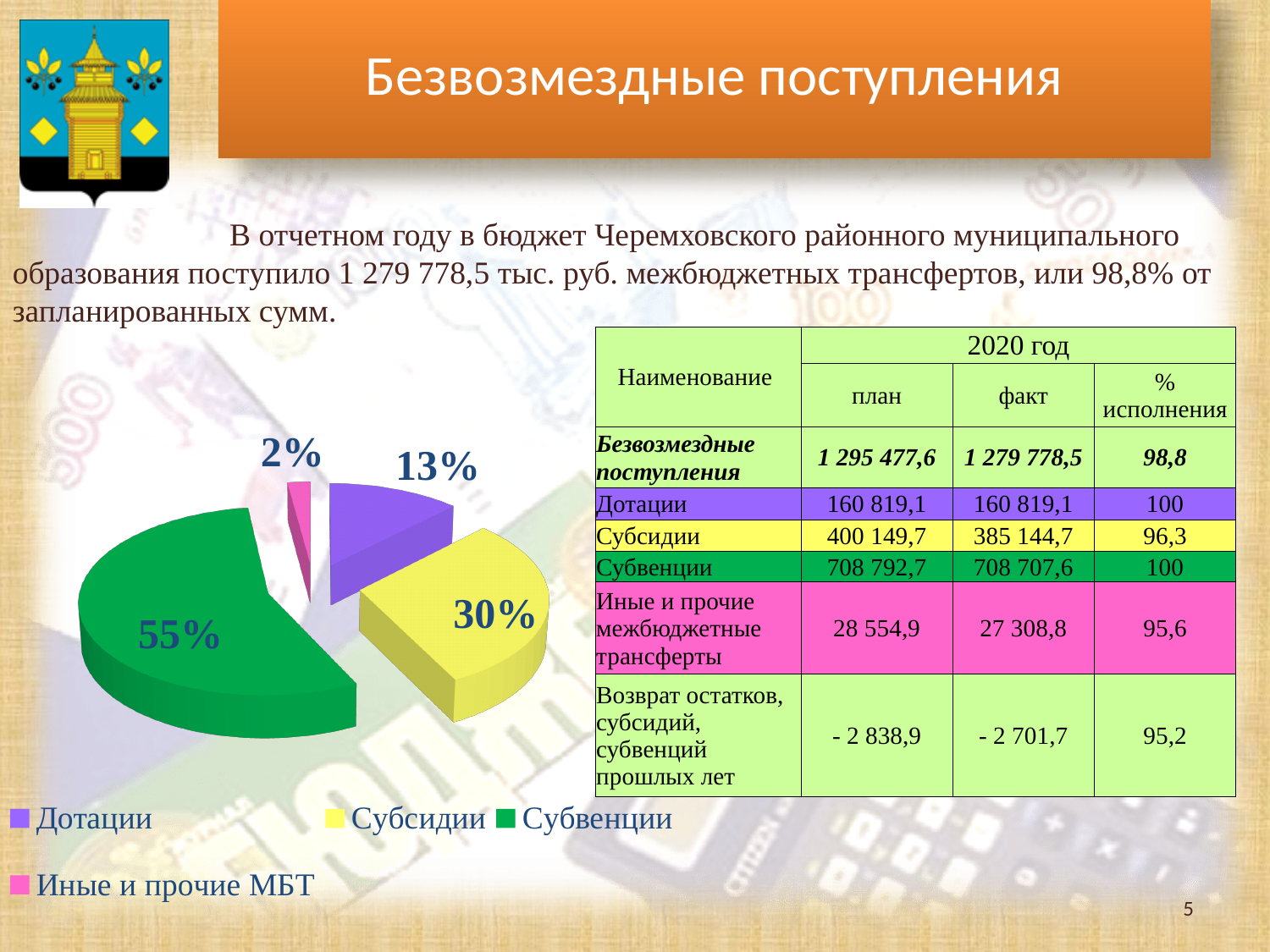
What share of the pie chart does Дотации have? 13% What is the difference in percentage points between the Субвенции slice and the Субсидии slice? 25 percentage points What colour is the Субвенции slice in the pie chart? Green Which category has the largest slice in the pie chart? Субвенции What share of the pie chart does Субсидии have? 30% Which slice is larger in the pie chart, Дотации or Субсидии? Субсидии Which category has the smallest slice in the pie chart? Иные и прочие МБТ How many entries does the pie chart legend list? 4 How many slices does the pie chart have? 4 What kind of chart is shown on the slide? Pie chart What share of the pie chart does Иные и прочие МБТ have? 2%